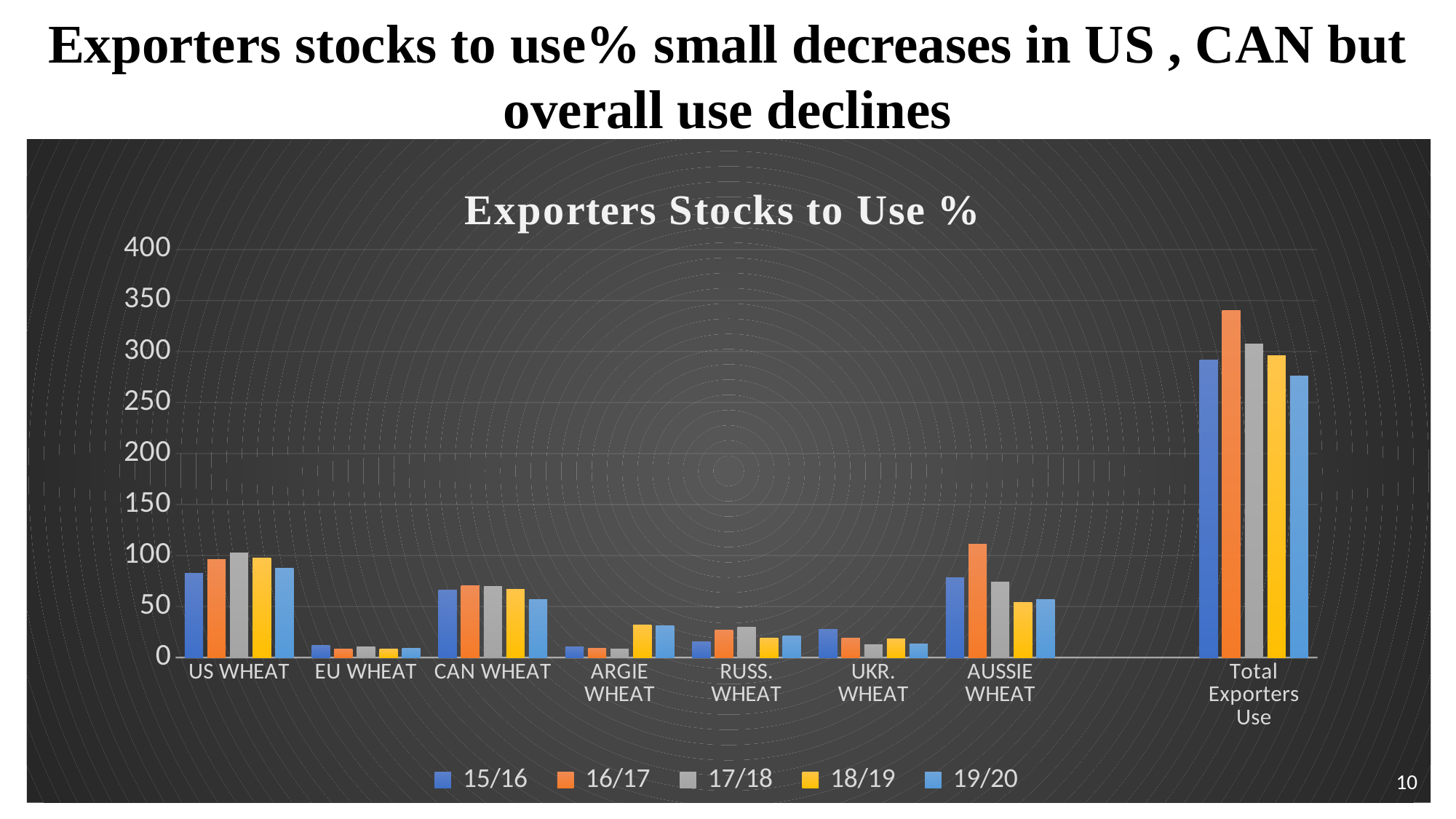
Is the 16/17 value for AUSSIE WHEAT greater or less than 100? greater For the 16/17 series, which is larger: AUSSIE WHEAT or US WHEAT? AUSSIE WHEAT Do the values for Total Exporters Use rise or fall from 16/17 to 19/20? fall What kind of chart is shown on the slide? bar chart Is the 19/20 value for Total Exporters Use greater or less than 300? less How many series does the legend list? 5 What is the title of the chart? Exporters Stocks to Use % How many categories are shown on the x axis? 8 Is the 16/17 value for Total Exporters Use greater or less than 300? greater Which series has the highest value for Total Exporters Use? 16/17 Which series has the lowest value for Total Exporters Use? 19/20